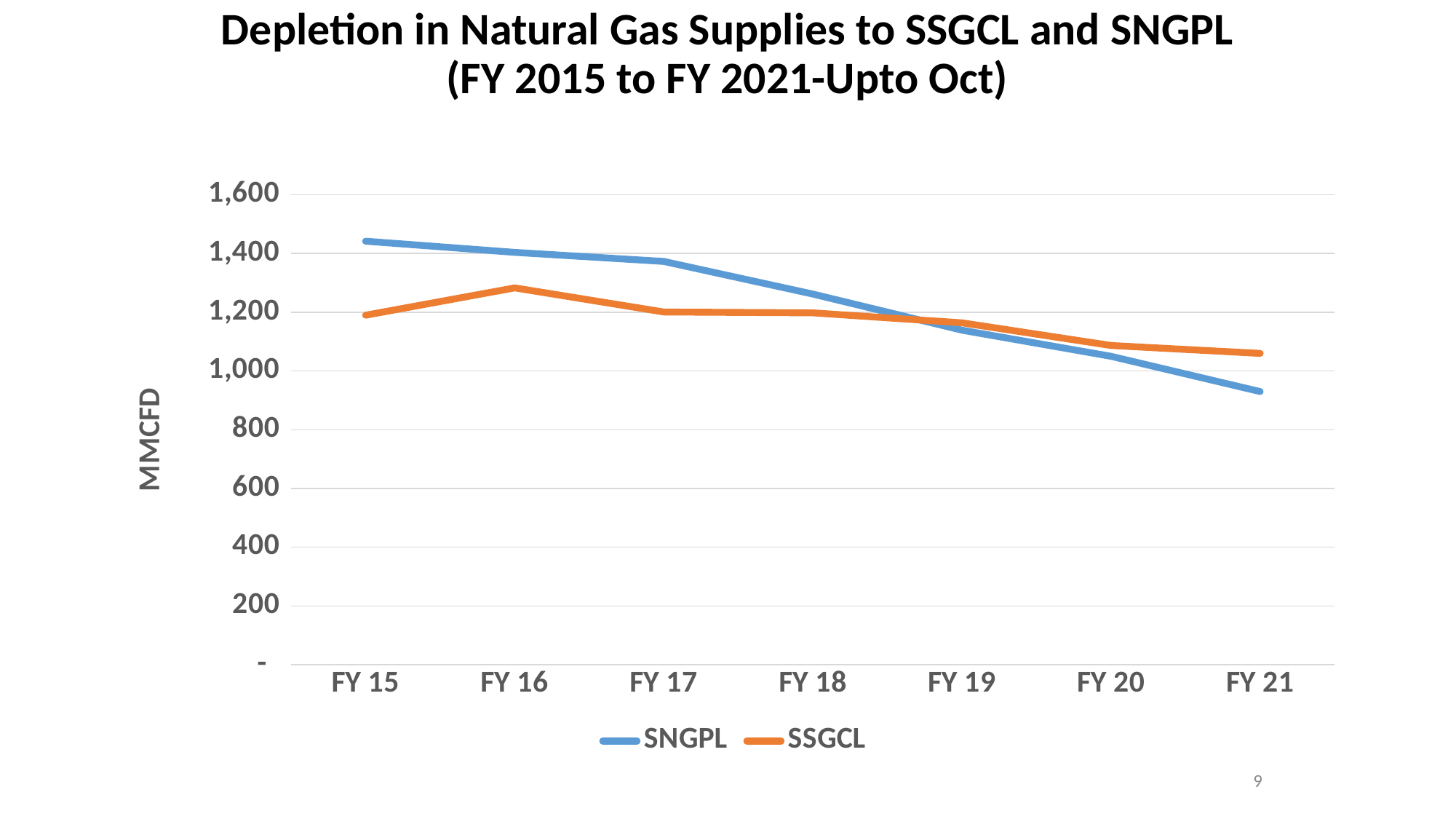
Does the SNGPL line rise or fall from FY 15 to FY 21? fall What kind of chart is shown on the slide? line chart In which fiscal year does the SSGCL line reach its highest value? FY 16 In FY 21, which series has the higher value, SNGPL or SSGCL? SSGCL In FY 15, which series has the higher value, SNGPL or SSGCL? SNGPL Is the SNGPL value for FY 15 greater or less than 1,400? greater Is the SSGCL value for FY 21 greater or less than 1,000? greater What unit is shown on the y axis label? MMCFD How many fiscal years are plotted along the x axis? 7 Is the SNGPL value for FY 21 greater or less than 1,000? less How many series does the legend list? 2